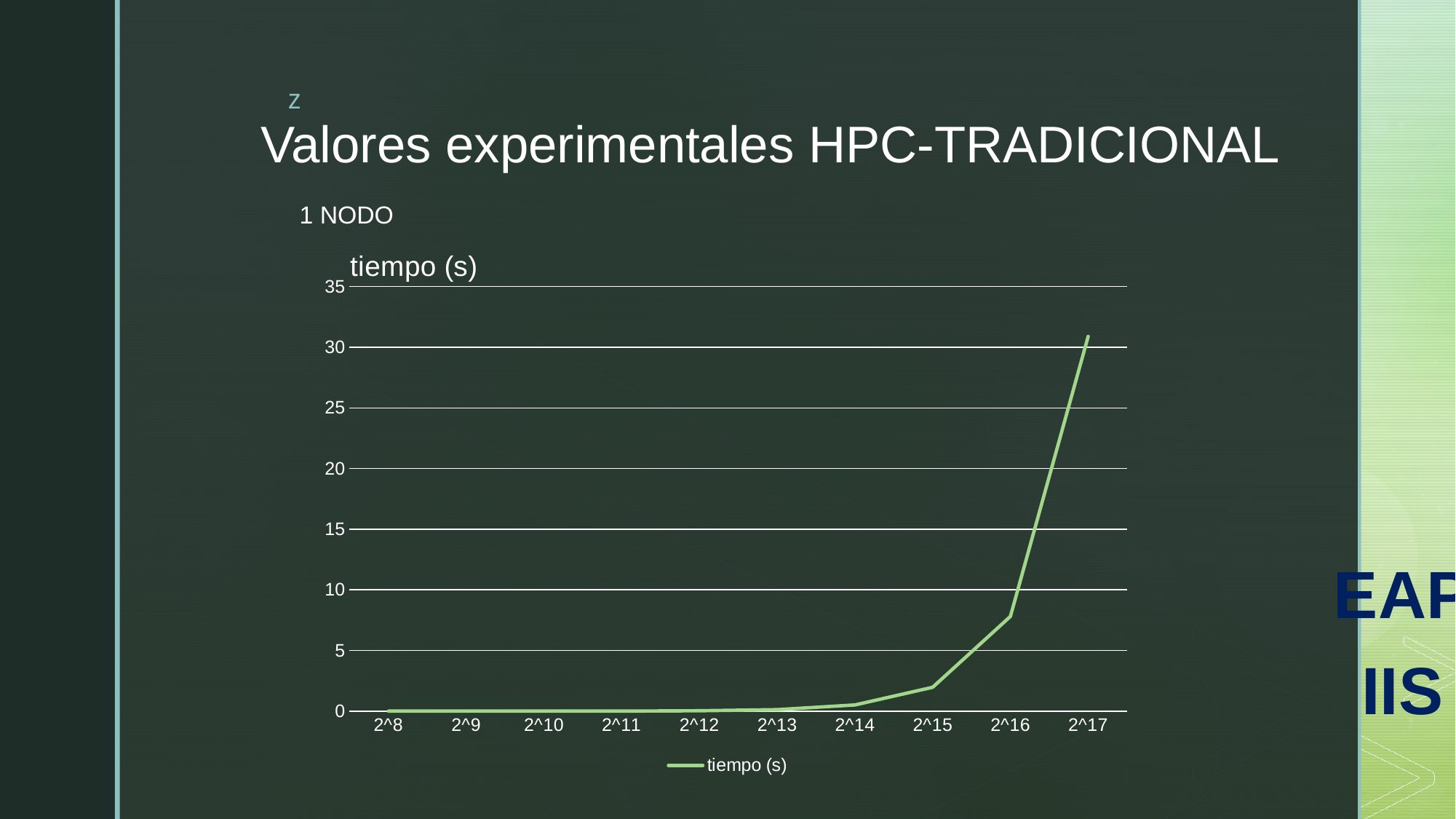
Which category has the highest value for tiempo (s)? 2^17 Is the value for 2^16 greater or less than 5? greater What is the name of the series shown in the legend? tiempo (s) How many series does the legend list? 1 How many categories are shown on the x axis? 10 Which is larger, the value for 2^16 or the value for 2^17? 2^17 Is the value for 2^17 greater or less than 30? greater Is the value for 2^15 greater or less than 5? less Do the values rise or fall along the x axis from 2^8 to 2^17? rise What kind of chart is shown on the slide? line chart What is the title of the chart? tiempo (s)